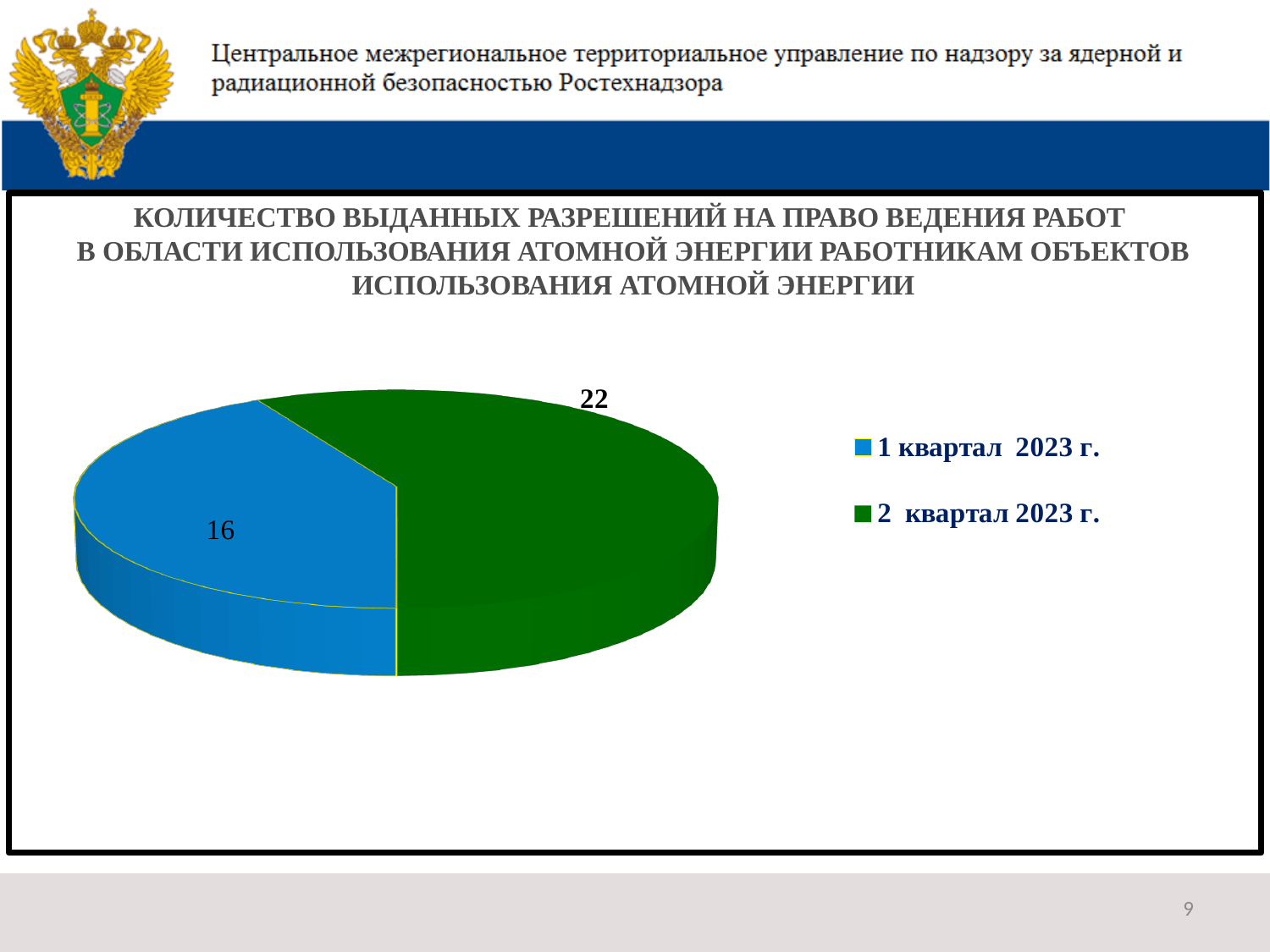
Which quarter has the larger number of issued permits? 2 квартал 2023 г. What is the value for 2 квартал 2023 г.? 22 What is the difference between the values for 2 квартал 2023 г. and 1 квартал 2023 г.? 6 How many slices does the pie chart have? 2 What colour is the slice for 1 квартал 2023 г.? blue What is the total of the two slices in the pie chart? 38 How many entries does the legend list? 2 Which quarter has the smaller number of issued permits? 1 квартал 2023 г. Is the value for 2 квартал 2023 г. larger or smaller than the value for 1 квартал 2023 г.? larger What type of chart is shown on the slide? pie chart What is the value for 1 квартал 2023 г.? 16